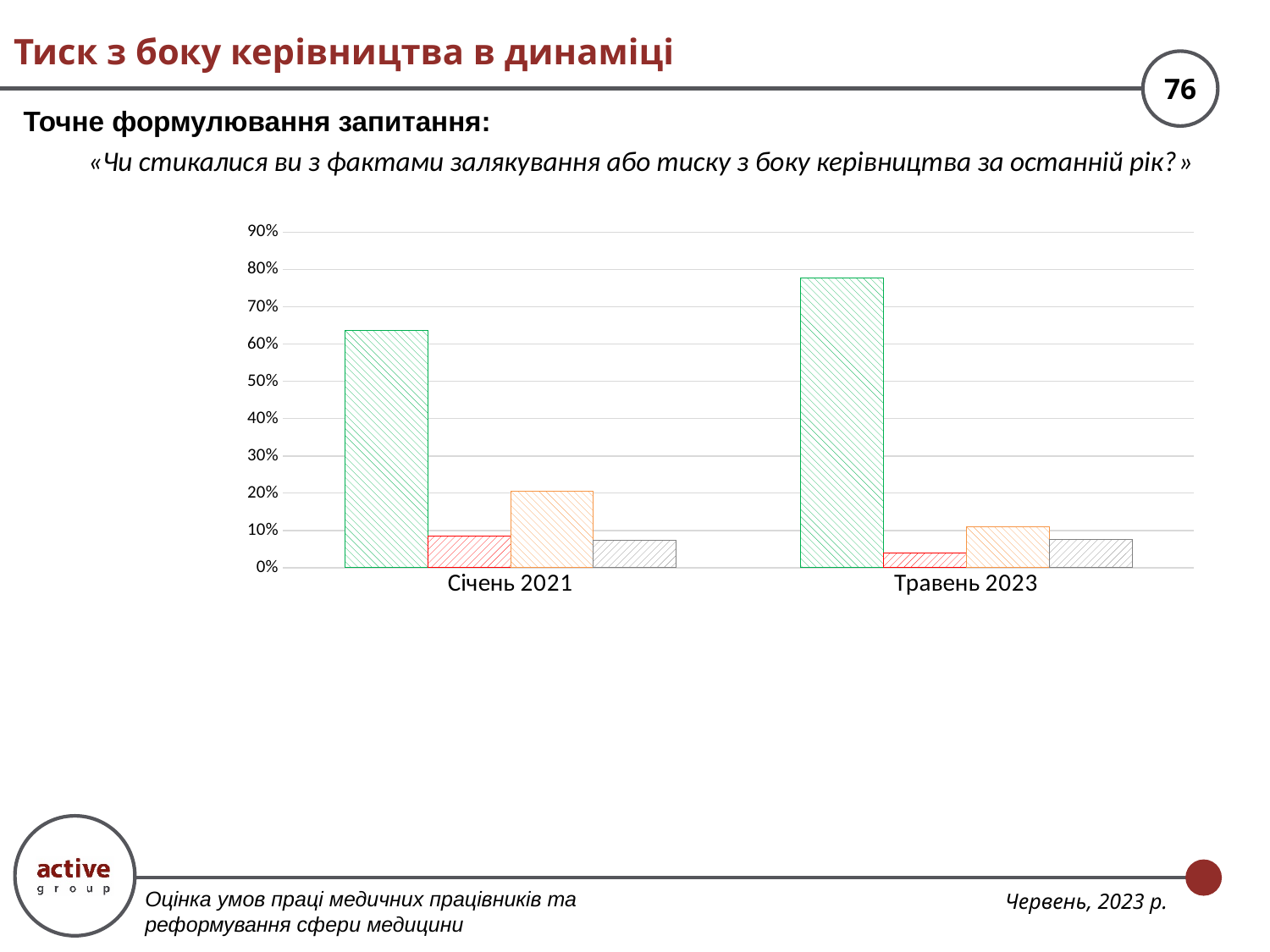
Is the orange bar larger for Січень 2021 or for Травень 2023? Січень 2021 Is the value of the grey bar for Січень 2021 greater or less than 10%? less Which bar is the shortest in the Травень 2023 group? the red bar How many bars are plotted for each category in the chart? 4 Is the value of the red bar for Травень 2023 greater or less than 10%? less What kind of chart is shown on the slide? bar chart Is the green bar larger for Січень 2021 or for Травень 2023? Травень 2023 Is the value of the green bar for Травень 2023 greater or less than 70%? greater Which bar is the tallest in the Січень 2021 group? the green bar How many categories are shown on the x axis of the chart? 2 What is the highest value shown on the vertical axis of the chart? 90%